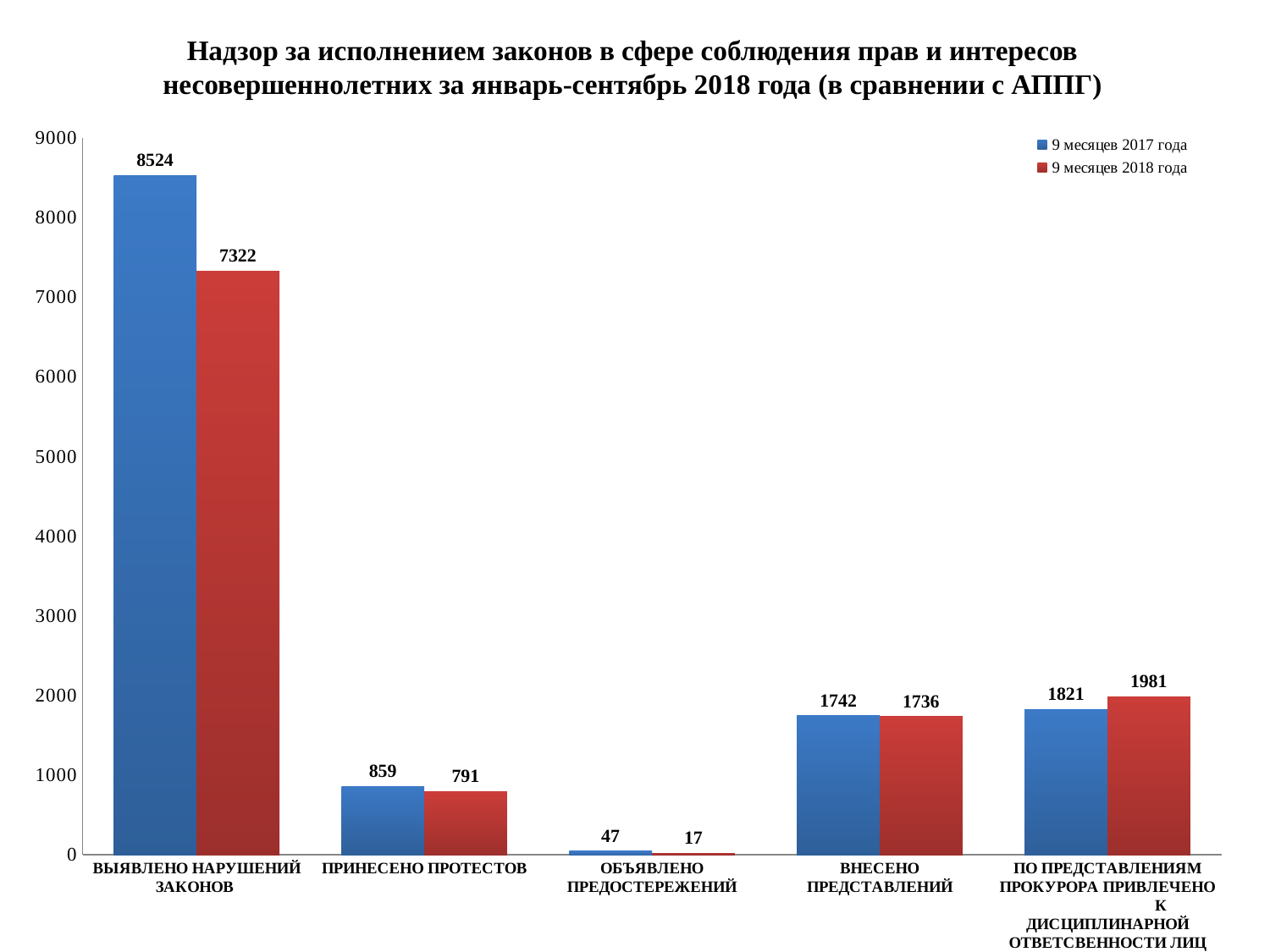
What is the difference between the 2018 and 2017 values for "По представлениям прокурора привлечено к дисциплинарной ответсвенности лиц"? 160 How many categories are shown on the x axis? 5 For "Принесено протестов", which series has the larger value: "9 месяцев 2017 года" or "9 месяцев 2018 года"? 9 месяцев 2017 года What is the difference between the 2017 and 2018 values for "Выявлено нарушений законов"? 1202 What is the value for "Объявлено предостережений" in the "9 месяцев 2018 года" series? 17 How many series does the legend list? 2 Which category has the lowest value in the "9 месяцев 2018 года" series? Объявлено предостережений What is the value for "Принесено протестов" in the "9 месяцев 2018 года" series? 791 What is the value for "Выявлено нарушений законов" in the "9 месяцев 2017 года" series? 8524 Which category has the highest value in the "9 месяцев 2017 года" series? Выявлено нарушений законов Is the value for "Внесено представлений" in the "9 месяцев 2018 года" series greater or less than 2000? less What kind of chart is shown on the slide? bar chart